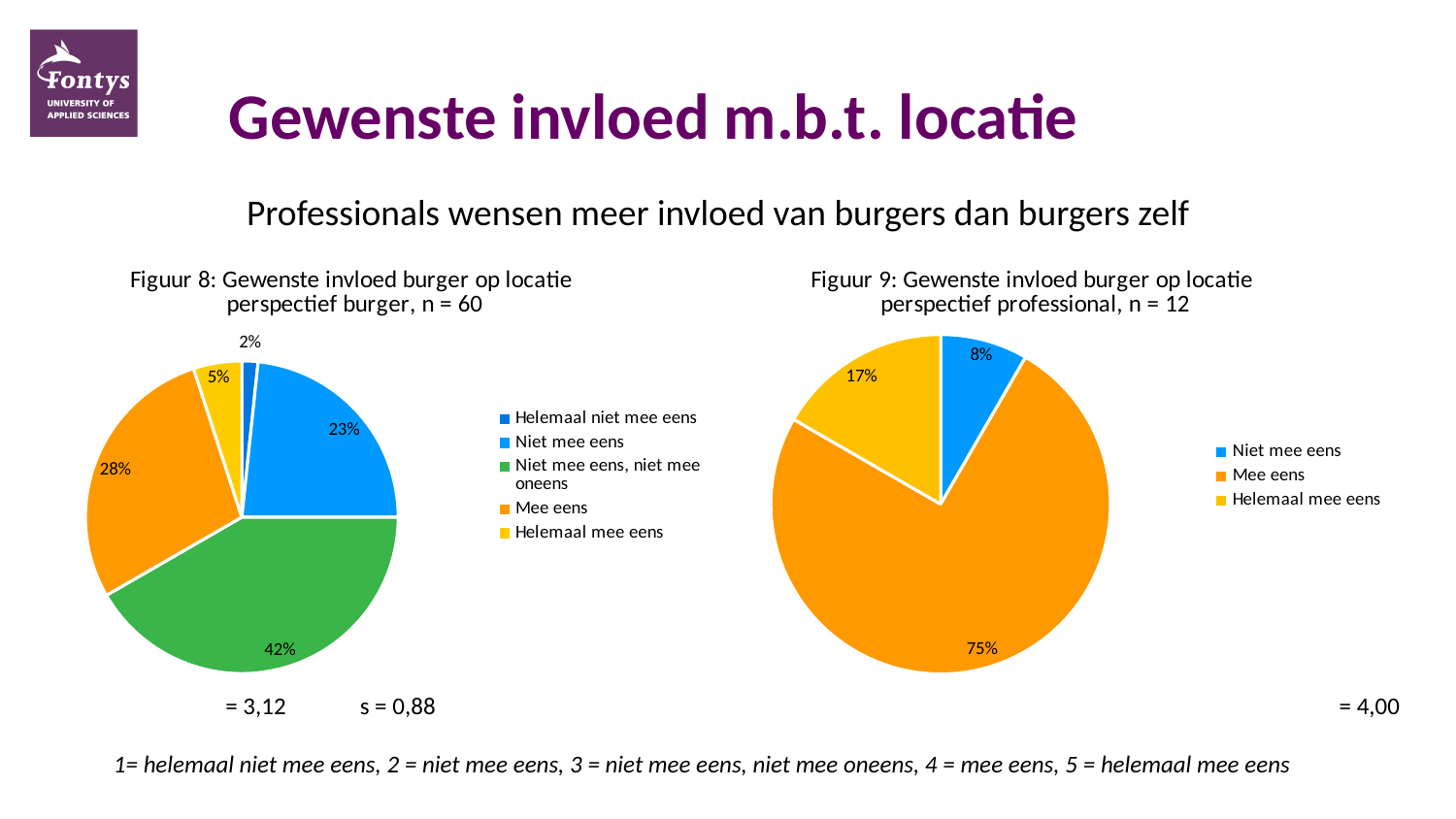
What type of chart is Figuur 9 (perspectief professional)? Pie chart Which is larger: 'Helemaal mee eens' in Figuur 8 or 'Helemaal mee eens' in Figuur 9? Figuur 9 In Figuur 9 (perspectief professional), how many categories does the legend list? 3 In Figuur 8 (perspectief burger), how many categories does the legend list? 5 In Figuur 8 (perspectief burger), which category has the smallest slice? Helemaal niet mee eens In Figuur 9 (perspectief professional), what percentage is shown for 'Helemaal mee eens'? 17% In Figuur 8 (perspectief burger), what share of the pie is 'Niet mee eens, niet mee oneens'? 42% In Figuur 8 (perspectief burger), what percentage is shown for 'Mee eens'? 28% In Figuur 9 (perspectief professional), what share of the pie is 'Mee eens'? 75% In Figuur 8 (perspectief burger), what is the difference in percentage points between 'Mee eens' and 'Niet mee eens'? 5 In Figuur 9 (perspectief professional), which category has the smallest slice? Niet mee eens In Figuur 8 (perspectief burger), which category has the largest slice? Niet mee eens, niet mee oneens